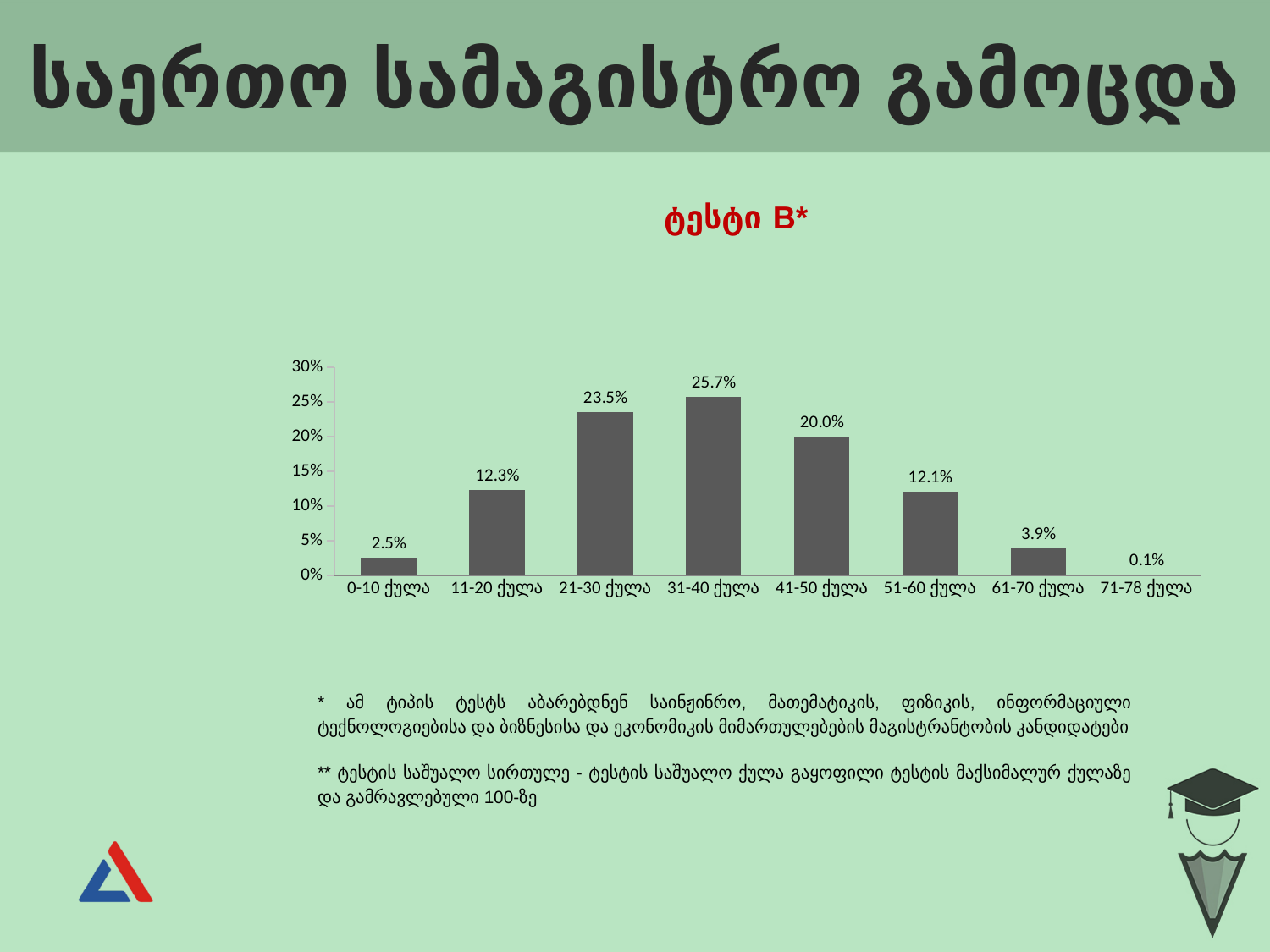
What is the value for the 31-40 ქულა category? 25.7% Which category has the lowest value? 71-78 ქულა What is the title of the chart? ტესტი B* What is the difference between the values for 11-20 ქულა and 51-60 ქულა? 0.2% What is the value for the 0-10 ქულა category? 2.5% What kind of chart is shown on the slide? bar chart Which category has the highest value? 31-40 ქულა What is the value for the 61-70 ქულა category? 3.9% What is the difference between the values for 21-30 ქულა and 41-50 ქულა? 3.5% How many categories are shown on the x axis? 8 Which is larger, the value for 21-30 ქულა or the value for 41-50 ქულა? 21-30 ქულა Is the value for 41-50 ქულა greater or less than 15%? greater